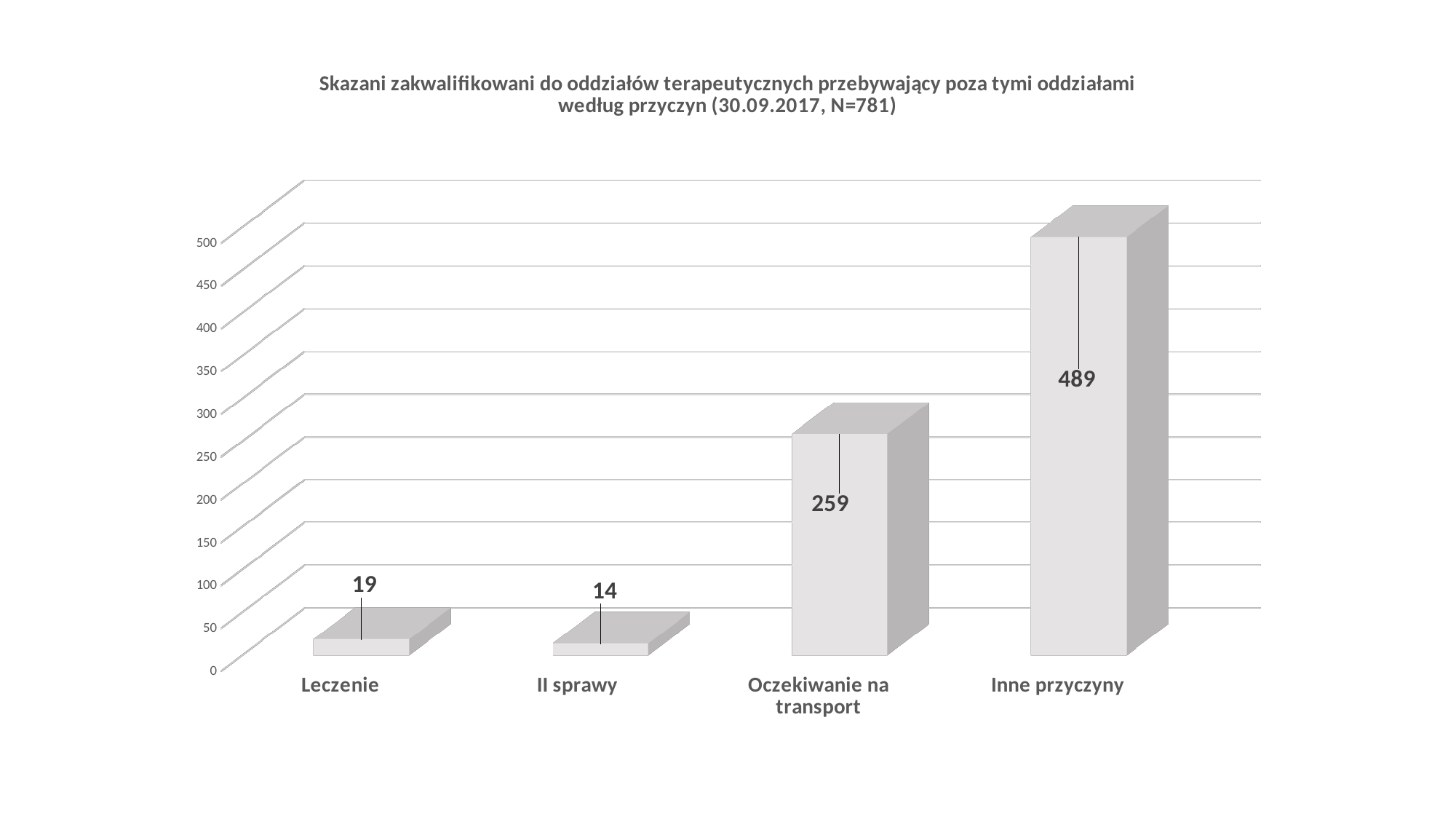
What is the value for II sprawy? 14 What kind of chart is shown on the slide? Bar chart Which category has the lowest value? II sprawy How many categories are shown on the chart? 4 What date is given in the chart title? 30.09.2017 What is the difference between the values for Inne przyczyny and Oczekiwanie na transport? 230 Which category has the highest value? Inne przyczyny What is the difference between the values for Leczenie and II sprawy? 5 What is the value for Oczekiwanie na transport? 259 Which is larger, the value for Oczekiwanie na transport or the value for Leczenie? Oczekiwanie na transport What is the value for Leczenie? 19 What is the value for Inne przyczyny? 489